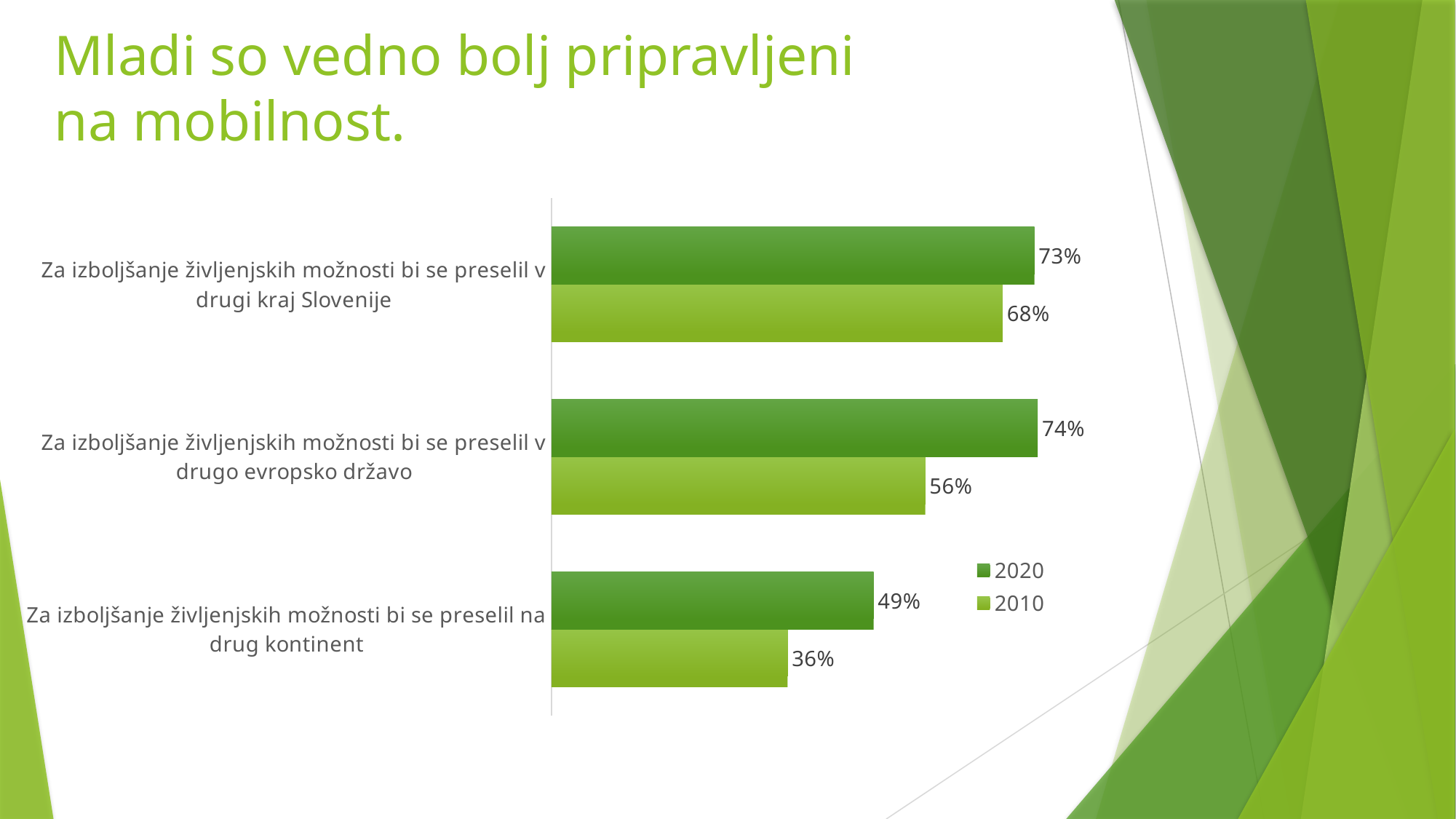
Which category has the highest 2020 value? Za izboljšanje življenjskih možnosti bi se preselil v drugo evropsko državo Which category has the lowest 2010 value? Za izboljšanje življenjskih možnosti bi se preselil na drug kontinent How many categories are shown in the chart? 3 What is the 2010 value for "Za izboljšanje življenjskih možnosti bi se preselil na drug kontinent"? 36% What kind of chart is shown on the slide? Bar chart For "Za izboljšanje življenjskih možnosti bi se preselil v drugi kraj Slovenije", which year has the larger value, 2020 or 2010? 2020 What is the difference between the 2020 and 2010 values for "Za izboljšanje življenjskih možnosti bi se preselil v drugo evropsko državo"? 18% How many series does the legend list? 2 What is the 2020 value for "Za izboljšanje življenjskih možnosti bi se preselil v drugi kraj Slovenije"? 73% What is the 2010 value for "Za izboljšanje življenjskih možnosti bi se preselil v drugo evropsko državo"? 56% What is the difference between the 2020 and 2010 values for "Za izboljšanje življenjskih možnosti bi se preselil na drug kontinent"? 13% What is the 2020 value for "Za izboljšanje življenjskih možnosti bi se preselil na drug kontinent"? 49%